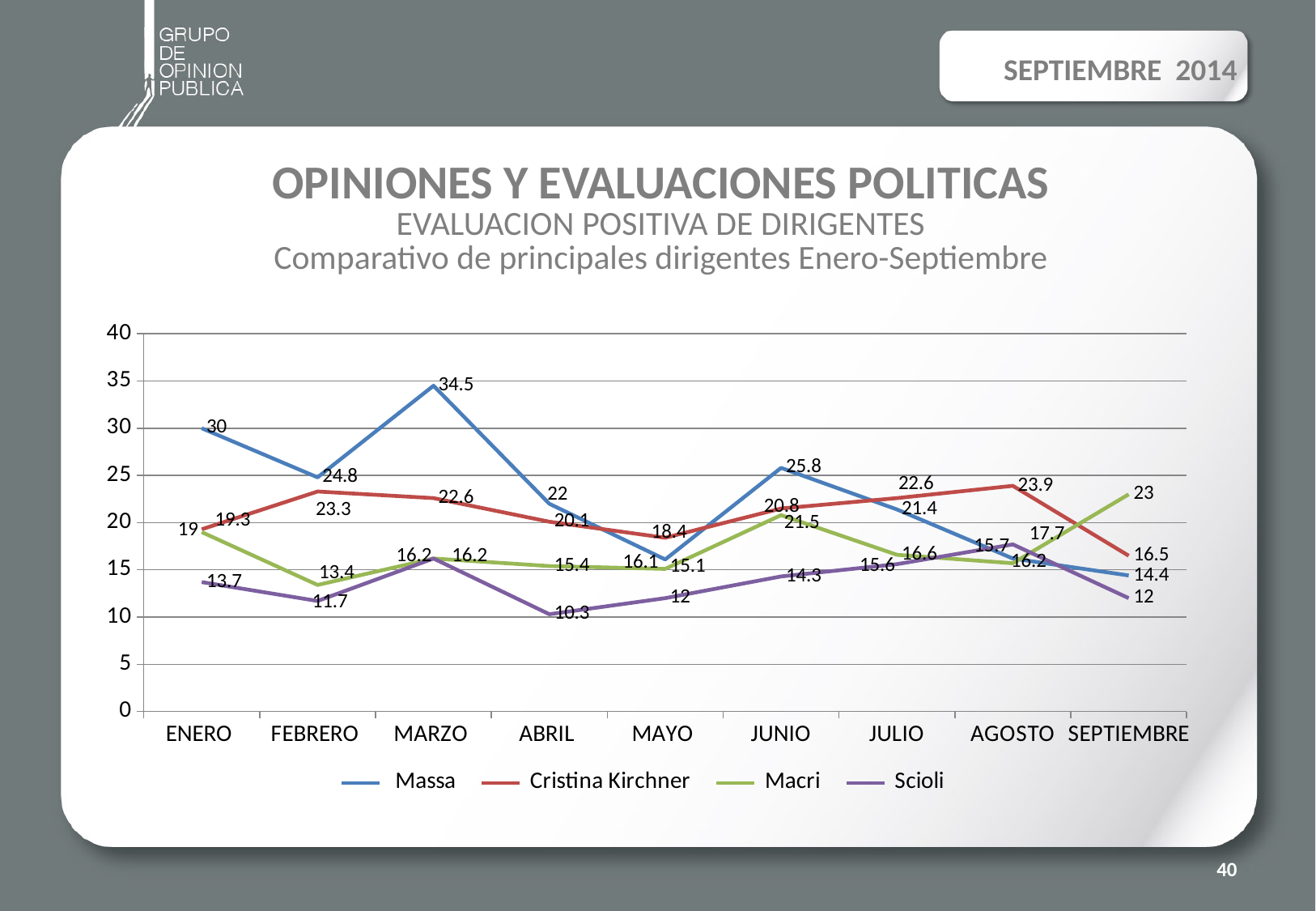
What kind of chart is shown on the slide? Line chart What is the value for Cristina Kirchner in AGOSTO? 23.9 In which month does Scioli have its lowest value? ABRIL How many months are shown on the x axis? 9 In which month does Massa reach its highest value? MARZO What is the difference between Massa's value in MARZO and in FEBRERO? 9.7 How many series does the legend list? 4 In ENERO, which is larger: the value for Massa or for Cristina Kirchner? Massa Does the value for Massa rise or fall from JUNIO to SEPTIEMBRE? Fall What is the value for Scioli in ABRIL? 10.3 In which month does Macri reach its highest value? SEPTIEMBRE What is the value for Massa in MARZO? 34.5